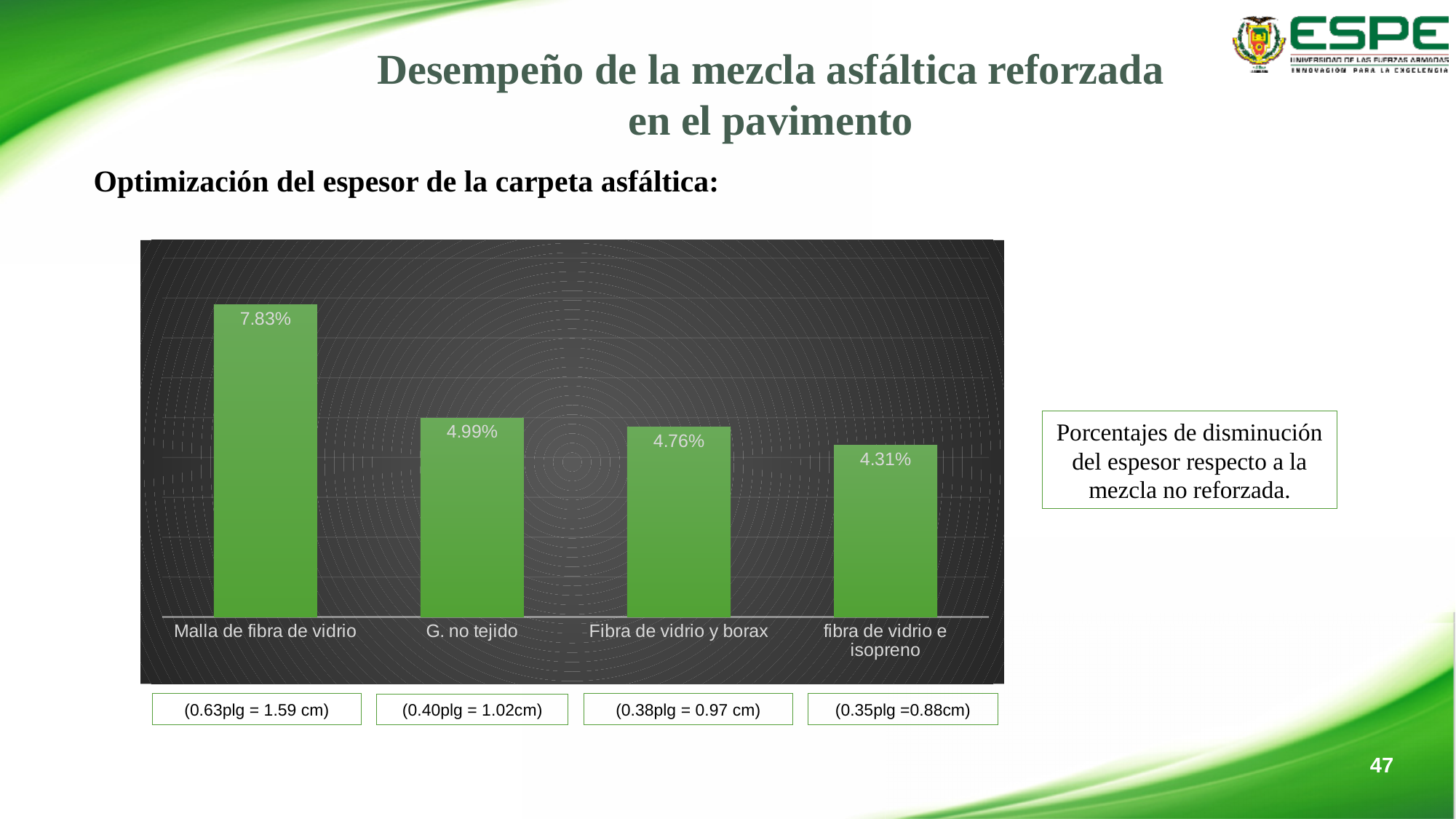
What is the difference between the values for Fibra de vidrio y borax and fibra de vidrio e isopreno? 0.45% Which category has the highest value? Malla de fibra de vidrio What is the value for Malla de fibra de vidrio? 7.83% Which category has the lowest value? fibra de vidrio e isopreno What is the difference between the values for Malla de fibra de vidrio and G. no tejido? 2.84% What is the value for Fibra de vidrio y borax? 4.76% How many categories are shown in the chart? 4 Do the values rise or fall from left to right across the categories? Fall Which is larger, the value for G. no tejido or the value for fibra de vidrio e isopreno? G. no tejido What is the value for fibra de vidrio e isopreno? 4.31% What is the value for G. no tejido? 4.99% What kind of chart is shown on the slide? Bar chart